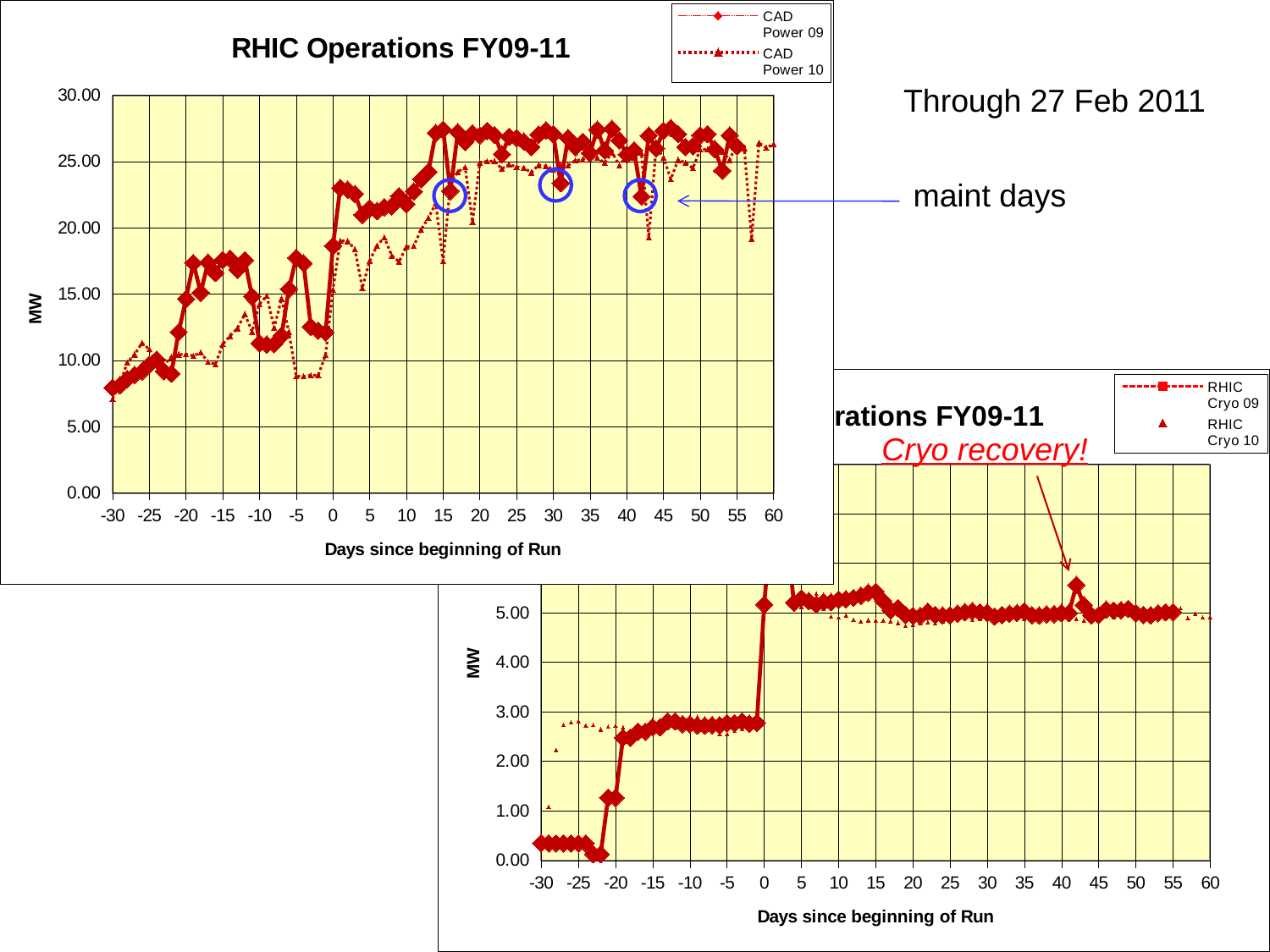
What kind of chart is the top-left chart titled 'RHIC Operations FY09-11'? Line chart In the top-left 'RHIC Operations FY09-11' chart, is the CAD Power 09 value at day 0 greater or less than 20.00? less In the bottom-right RHIC Cryo chart, is the RHIC Cryo 09 value at day -10 greater or less than 2.00? greater How many series does the legend of the top-left 'RHIC Operations FY09-11' chart list? 2 In the top-left 'RHIC Operations FY09-11' chart, what are the two series named in the legend? CAD Power 09 and CAD Power 10 What is the x-axis label of the bottom-right RHIC Cryo chart? Days since beginning of Run In the top-left 'RHIC Operations FY09-11' chart, is the CAD Power 09 value at day -30 greater or less than 10.00? less How many series does the legend of the bottom-right RHIC Cryo chart list? 2 In the top-left 'RHIC Operations FY09-11' chart, do the CAD Power 09 values generally rise or fall from day -30 to day 20? rise What kind of chart is the bottom-right chart with the RHIC Cryo 09 and RHIC Cryo 10 series? Line chart